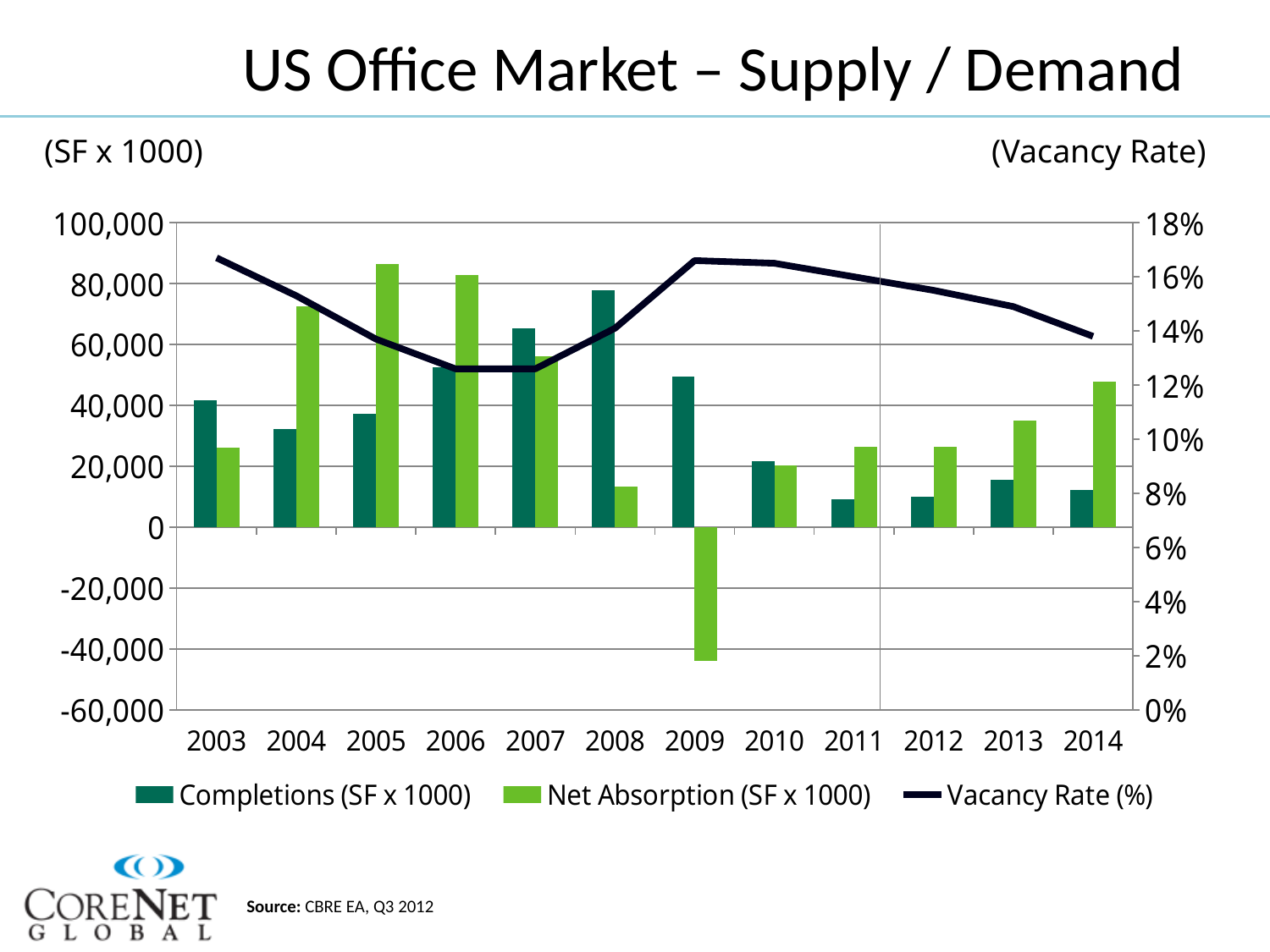
Is the value for Net Absorption in 2009 greater or less than -20,000? less In 2004, which is larger: Completions or Net Absorption? Net Absorption Does the Vacancy Rate rise or fall from 2009 to 2014? fall Is the value for Completions in 2008 greater or less than 60,000? greater Is the value for Completions in 2011 greater or less than 20,000? less In which year are Completions (SF x 1000) highest? 2008 How many series does the legend list? 3 How many years are shown on the x axis? 12 In 2007, which is larger: Completions or Net Absorption? Completions In which year is Net Absorption (SF x 1000) lowest? 2009 What kind of chart is shown on the slide? A combined bar and line chart